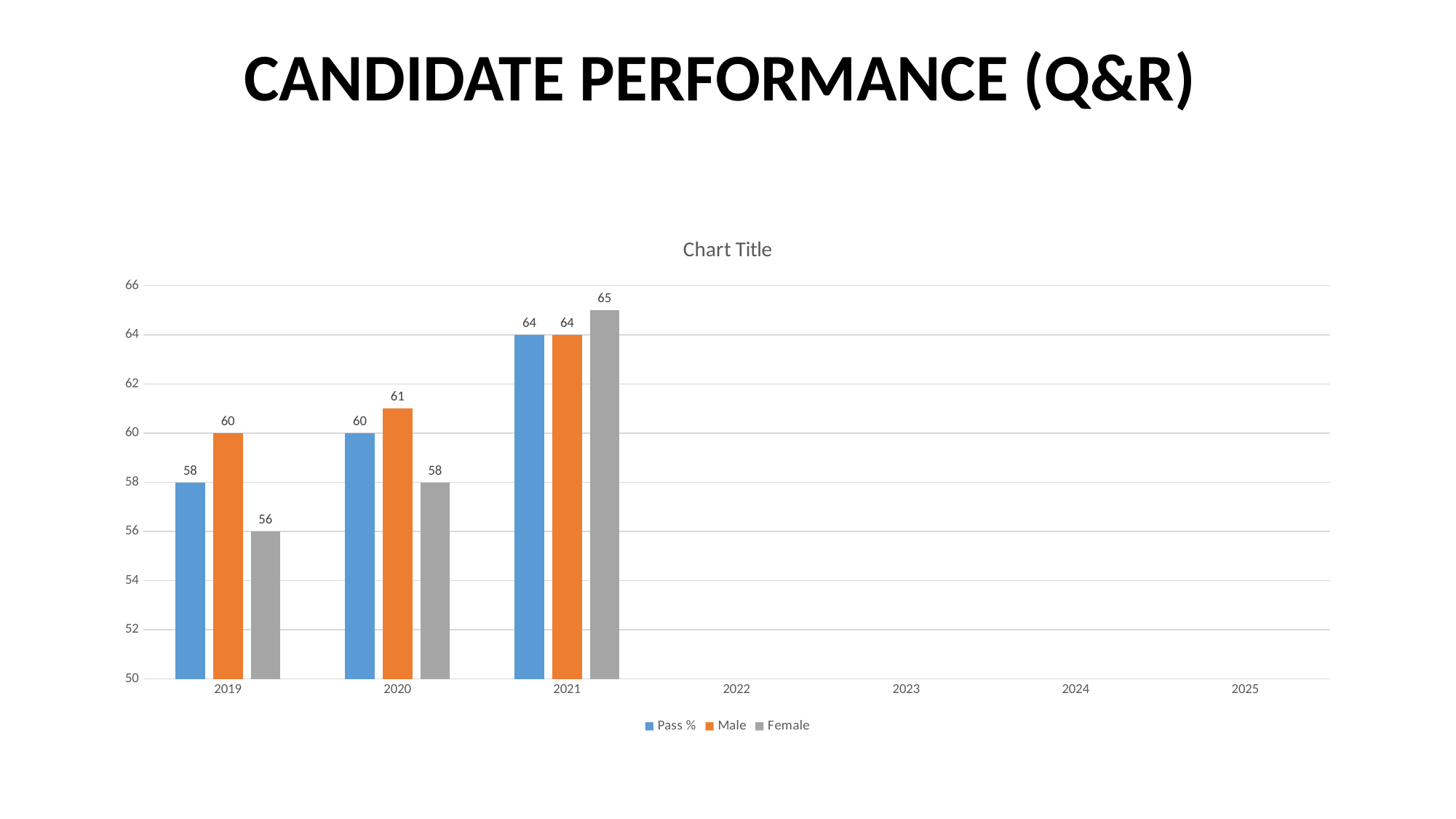
What is the Male value for 2020? 61 Which colour represents the Male series? Orange What is the difference between the Male and Female values in 2019? 4 Does the Pass % value rise or fall from 2019 to 2021? Rise What is the Pass % value for 2019? 58 What is the Female value for 2021? 65 Which is larger in 2020, the Male value or the Female value? Male What kind of chart is shown on the slide? Bar chart Which year has the lowest Pass % value? 2019 How many series does the legend list? 3 How many years are labelled on the x axis? 7 Which year has the highest Female value? 2021